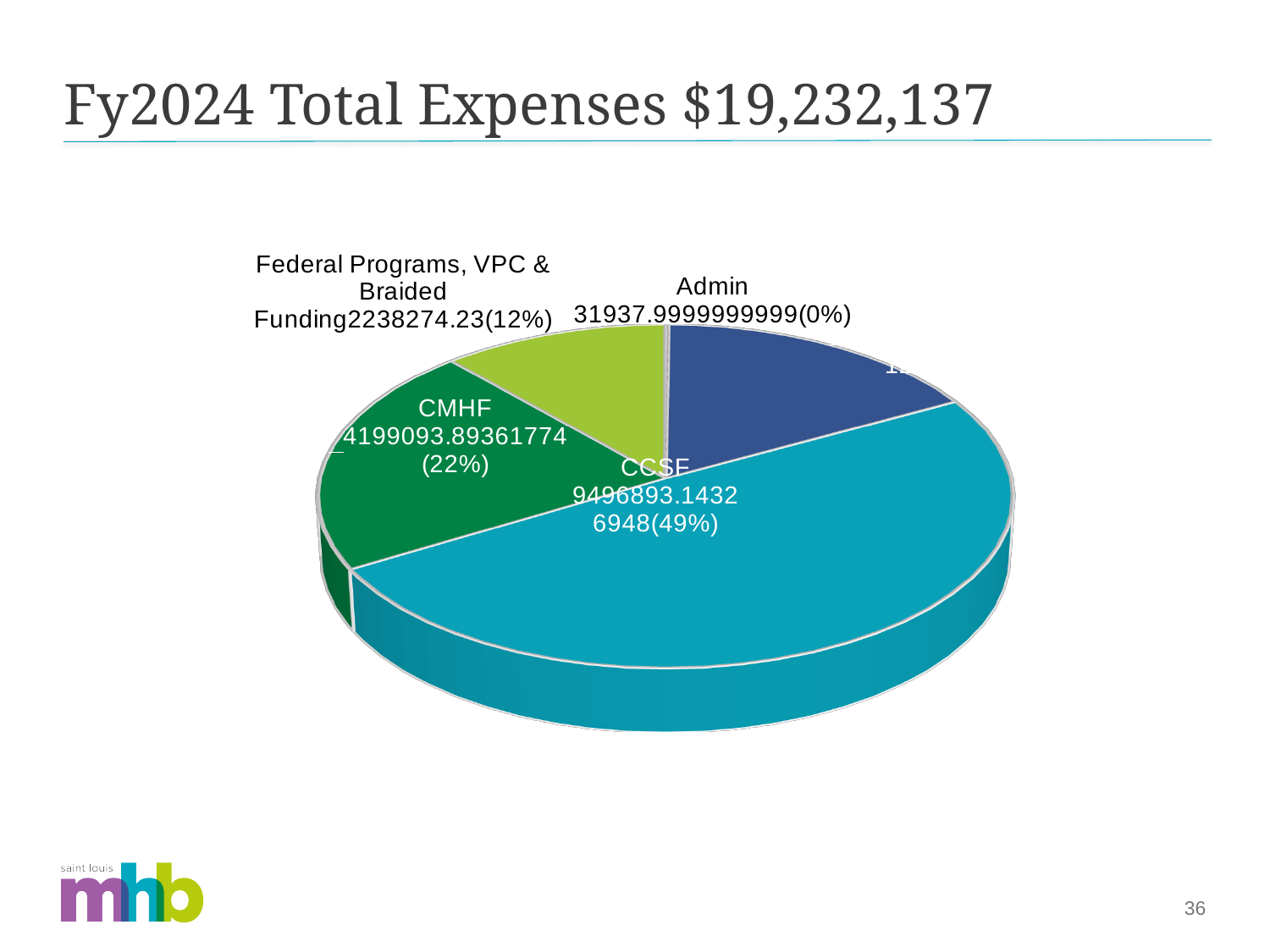
What share of the pie does Federal Programs, VPC & Braided Funding represent? 12% What is the value shown for Federal Programs, VPC & Braided Funding? 2238274.23 What is the title of the slide containing the chart? Fy2024 Total Expenses $19,232,137 Which labeled category has the largest slice of the pie? CCSF Which is larger, the CMHF slice or the Federal Programs, VPC & Braided Funding slice? CMHF What kind of chart is shown on the slide? pie chart What is the value shown for Admin? 31937.9999999999 What is the value shown for CMHF? 4199093.89361774 What share of the pie does CMHF represent? 22% What share of the pie does Admin represent? 0% Which labeled category has the smallest slice of the pie? Admin